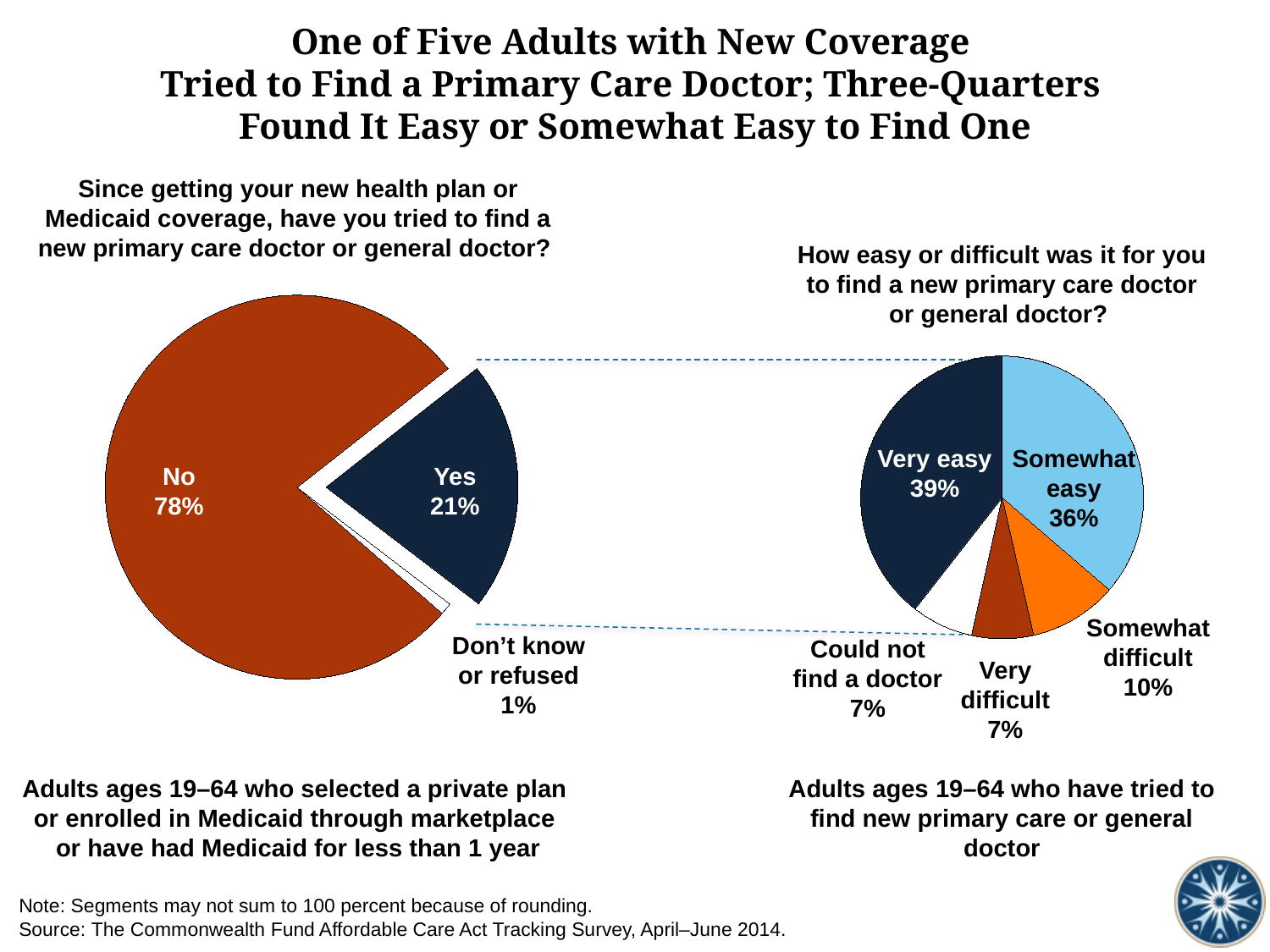
In the right pie chart (how easy or difficult was it to find a doctor), which response has the smallest share, Somewhat easy or Very difficult? Very difficult In the left pie chart (have you tried to find a new primary care doctor), what percentage answered Yes? 21% In the right pie chart (how easy or difficult was it to find a doctor), what is the difference between the Very easy and Somewhat easy percentages? 3% In the right pie chart (how easy or difficult was it to find a doctor), what percentage said Very easy? 39% In the left pie chart (have you tried to find a new primary care doctor), how many slices are there? 3 In the right pie chart (how easy or difficult was it to find a doctor), how many response categories are shown? 5 In the left pie chart (have you tried to find a new primary care doctor), which response has the largest slice? No In the left pie chart (have you tried to find a new primary care doctor), what percentage answered No? 78% In the right pie chart (how easy or difficult was it to find a doctor), what percentage could not find a doctor? 7% In the right pie chart (how easy or difficult was it to find a doctor), what percentage said Somewhat difficult? 10% In the left pie chart (have you tried to find a new primary care doctor), what share is Don't know or refused? 1% What type of chart is used on the right side of the slide? Pie chart